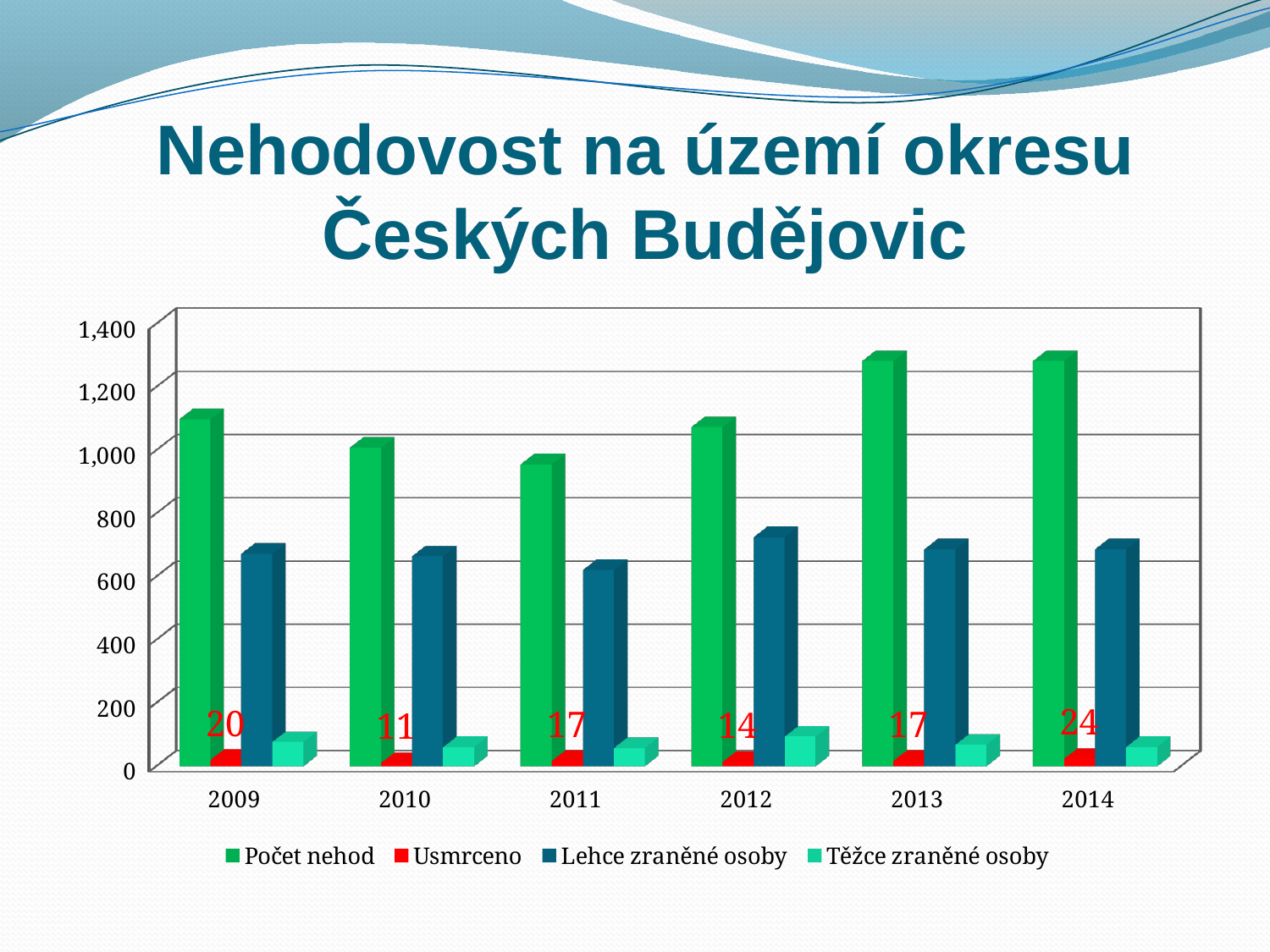
What is the difference between the Usmrceno values for 2014 and 2010? 13 In which year is the Usmrceno value highest? 2014 How many years are shown on the x axis? 6 How many series does the legend list? 4 What is the value for Usmrceno in 2014? 24 What kind of chart is shown on the slide? bar chart Is the value for Lehce zraněné osoby in 2012 greater or less than 600? greater What is the value for Usmrceno in 2009? 20 Is the value for Počet nehod in 2013 greater or less than 1,200? greater In which year is the Usmrceno value lowest? 2010 Is the value for Počet nehod in 2011 greater or less than 1,000? less Which year has the larger Usmrceno value, 2009 or 2012? 2009